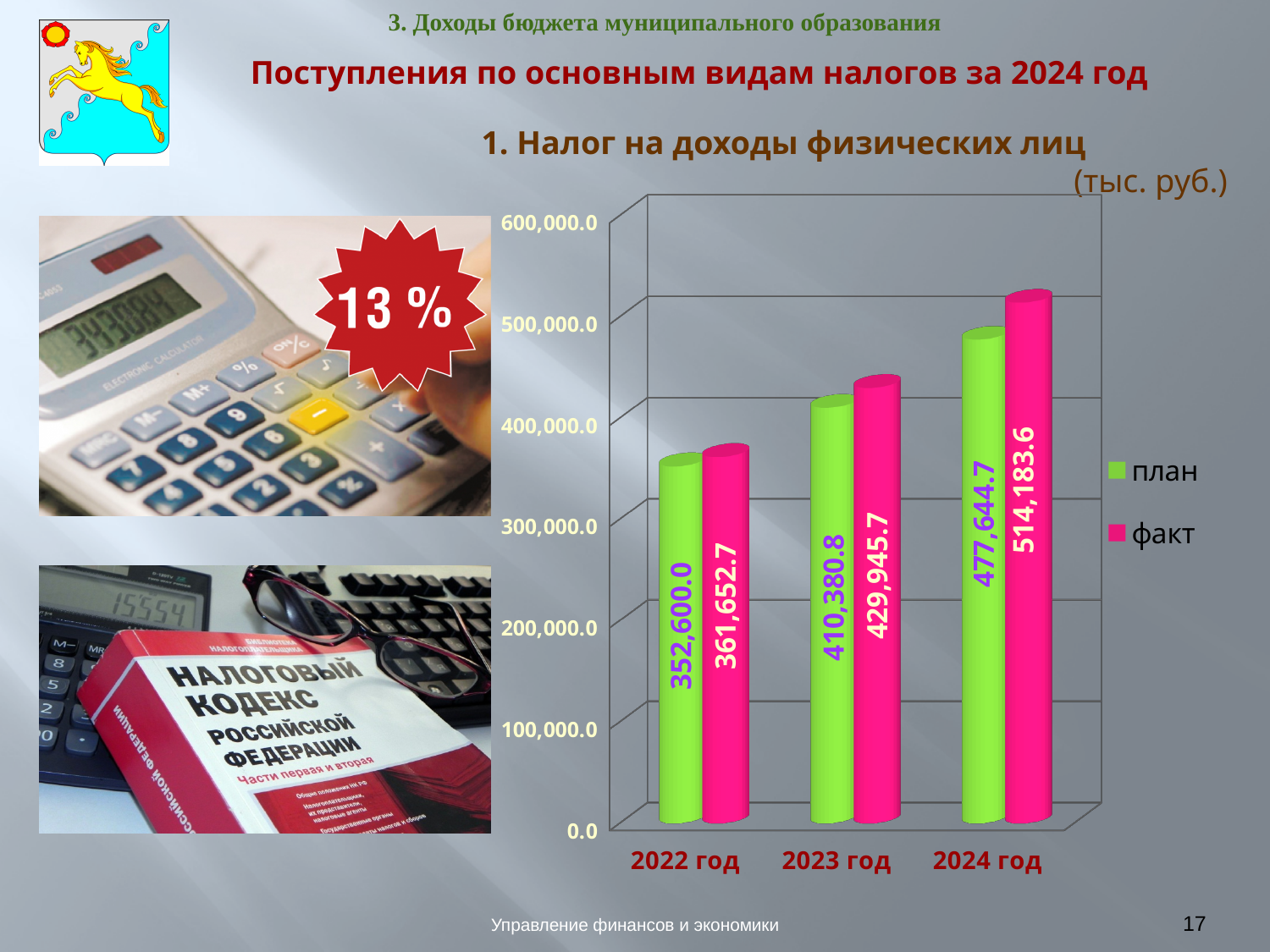
Which year has the highest факт value? 2024 год Which year has the lowest план value? 2022 год What is the план value for 2022 год? 352,600.0 How many years are shown on the x axis? 3 What is the difference between факт and план for 2024 год? 36,538.9 What is the факт value for 2023 год? 429,945.7 What is the факт value for 2024 год? 514,183.6 Is the факт value for 2024 год greater or less than 500,000.0? greater How many series does the legend list? 2 Do the факт values rise or fall from 2022 год to 2024 год? rise Which is larger for 2023 год, план or факт? факт What is the difference between the факт values for 2024 год and 2022 год? 152,530.9